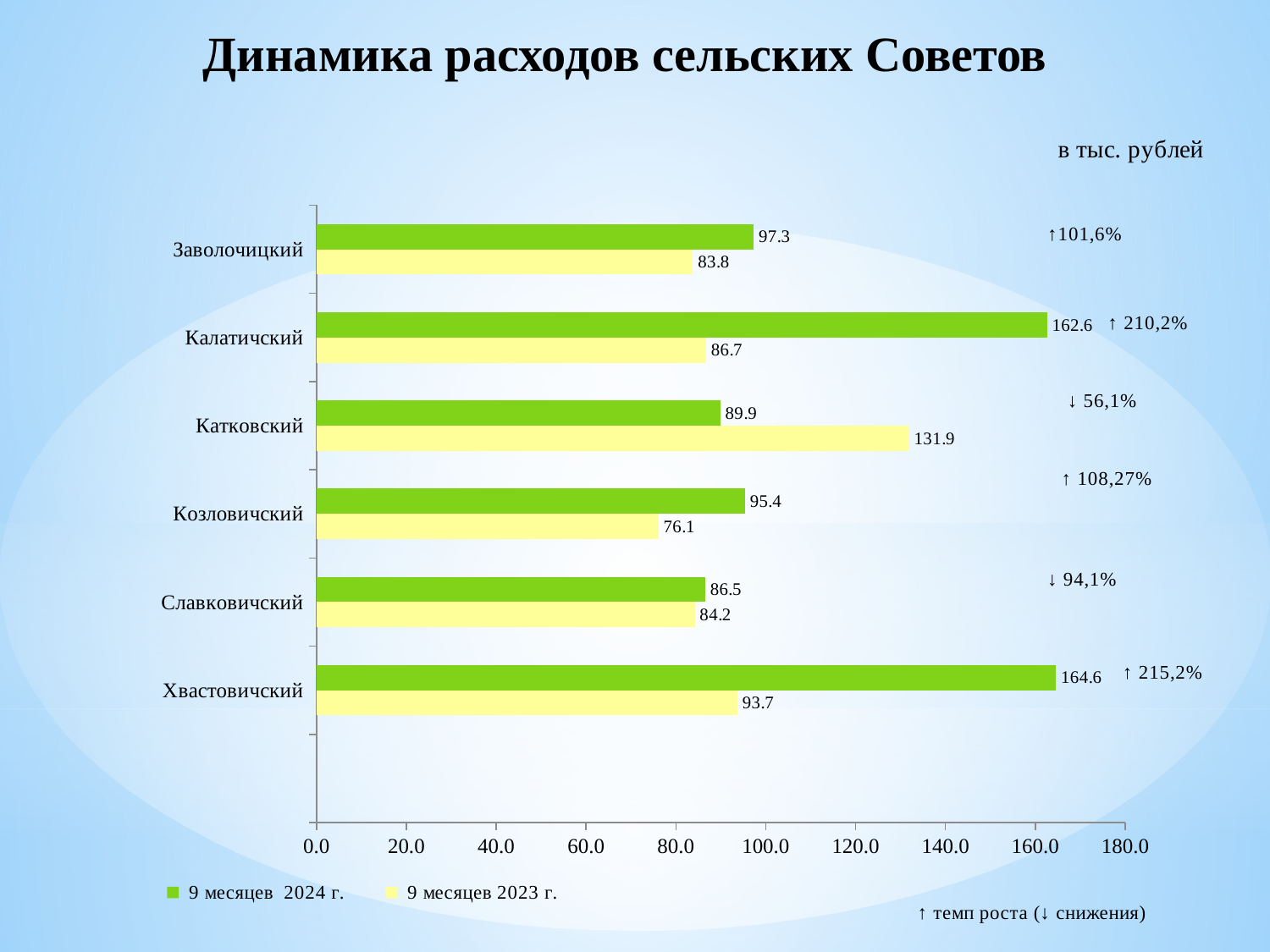
What is the title of the slide? Динамика расходов сельских Советов Which category has the highest value in the series 9 месяцев 2024 г.? Хвастовичский What kind of chart is shown on the slide? bar chart Is the 9 месяцев 2024 г. value for Заволочицкий greater or less than 80.0? greater What is the value for Козловичский in the series 9 месяцев 2023 г.? 76.1 How many series does the legend list? 2 What is the value for Калатичский in the series 9 месяцев 2024 г.? 162.6 Which category has the lowest value in the series 9 месяцев 2023 г.? Козловичский How many categories (сельские Советы) are shown on the chart? 6 What is the value for Катковский in the series 9 месяцев 2023 г.? 131.9 What is the difference between the 9 месяцев 2024 г. and 9 месяцев 2023 г. values for Хвастовичский? 70.9 Which is larger for Катковский: the 9 месяцев 2024 г. value or the 9 месяцев 2023 г. value? 9 месяцев 2023 г.